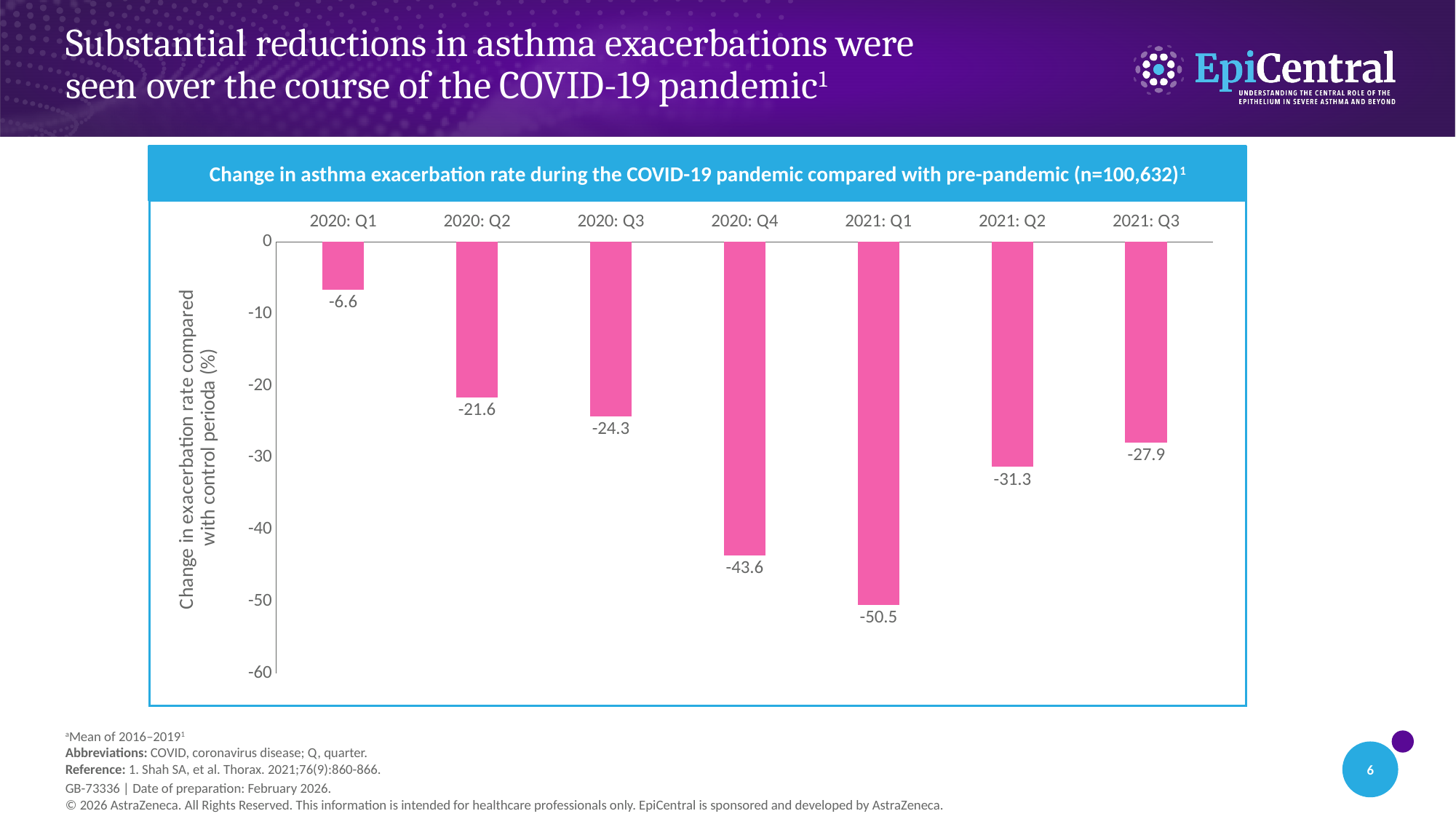
What type of chart is shown on the slide? Bar chart What is the change in asthma exacerbation rate for 2021: Q1? -50.5 What is the title of the chart? Change in asthma exacerbation rate during the COVID-19 pandemic compared with pre-pandemic (n=100,632) How many quarters are plotted in the chart? 7 What value is shown for 2020: Q4? -43.6 Which quarter has a larger reduction, 2020: Q3 or 2021: Q2? 2021: Q2 Which quarter shows the largest reduction in asthma exacerbation rate? 2021: Q1 What is the difference between the values for 2020: Q2 and 2020: Q1? 15 What is the difference between the values for 2021: Q1 and 2020: Q4? 6.9 Which quarter shows the smallest reduction in asthma exacerbation rate? 2020: Q1 What value is shown for 2021: Q3? -27.9 What is the change in asthma exacerbation rate for 2020: Q1? -6.6